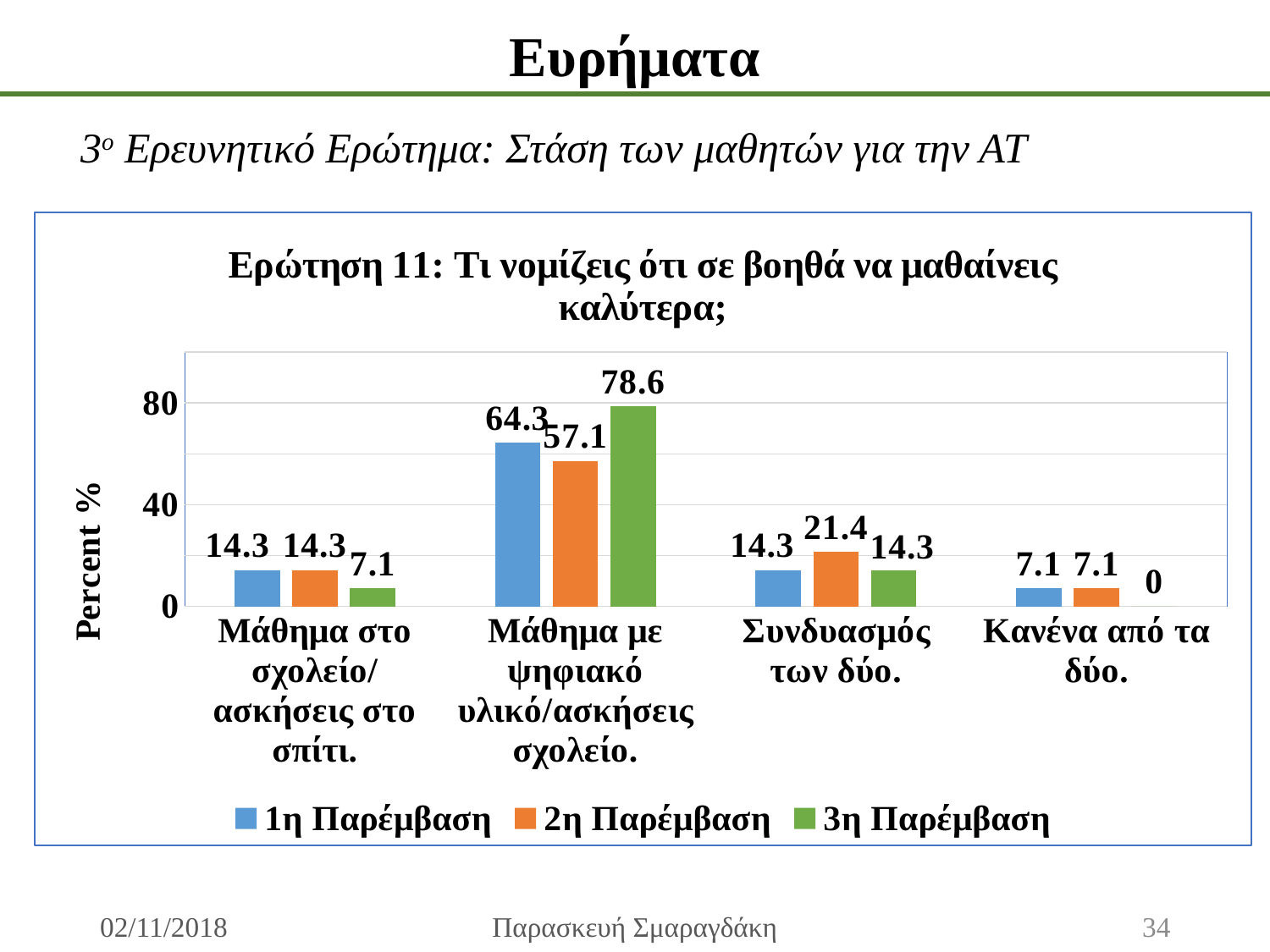
What is the value for 1η Παρέμβαση in the category 'Μάθημα στο σχολείο/ασκήσεις στο σπίτι.'? 14.3 What kind of chart is shown on the slide? bar chart In the category 'Μάθημα με ψηφιακό υλικό/ασκήσεις σχολείο.', which is larger: the value for 1η Παρέμβαση or 2η Παρέμβαση? 1η Παρέμβαση Which category has the highest value for 1η Παρέμβαση? Μάθημα με ψηφιακό υλικό/ασκήσεις σχολείο. Is the value for 3η Παρέμβαση in 'Μάθημα με ψηφιακό υλικό/ασκήσεις σχολείο.' greater or less than 40? greater What is the difference between the 3η Παρέμβαση and 2η Παρέμβαση values in the category 'Μάθημα με ψηφιακό υλικό/ασκήσεις σχολείο.'? 21.5 What is the value for 3η Παρέμβαση in the category 'Μάθημα με ψηφιακό υλικό/ασκήσεις σχολείο.'? 78.6 Which category has the lowest value for 3η Παρέμβαση? Κανένα από τα δύο. How many categories are shown on the x axis? 4 How many series does the legend list? 3 What is the value for 3η Παρέμβαση in the category 'Κανένα από τα δύο.'? 0 What is the value for 2η Παρέμβαση in the category 'Συνδυασμός των δύο.'? 21.4